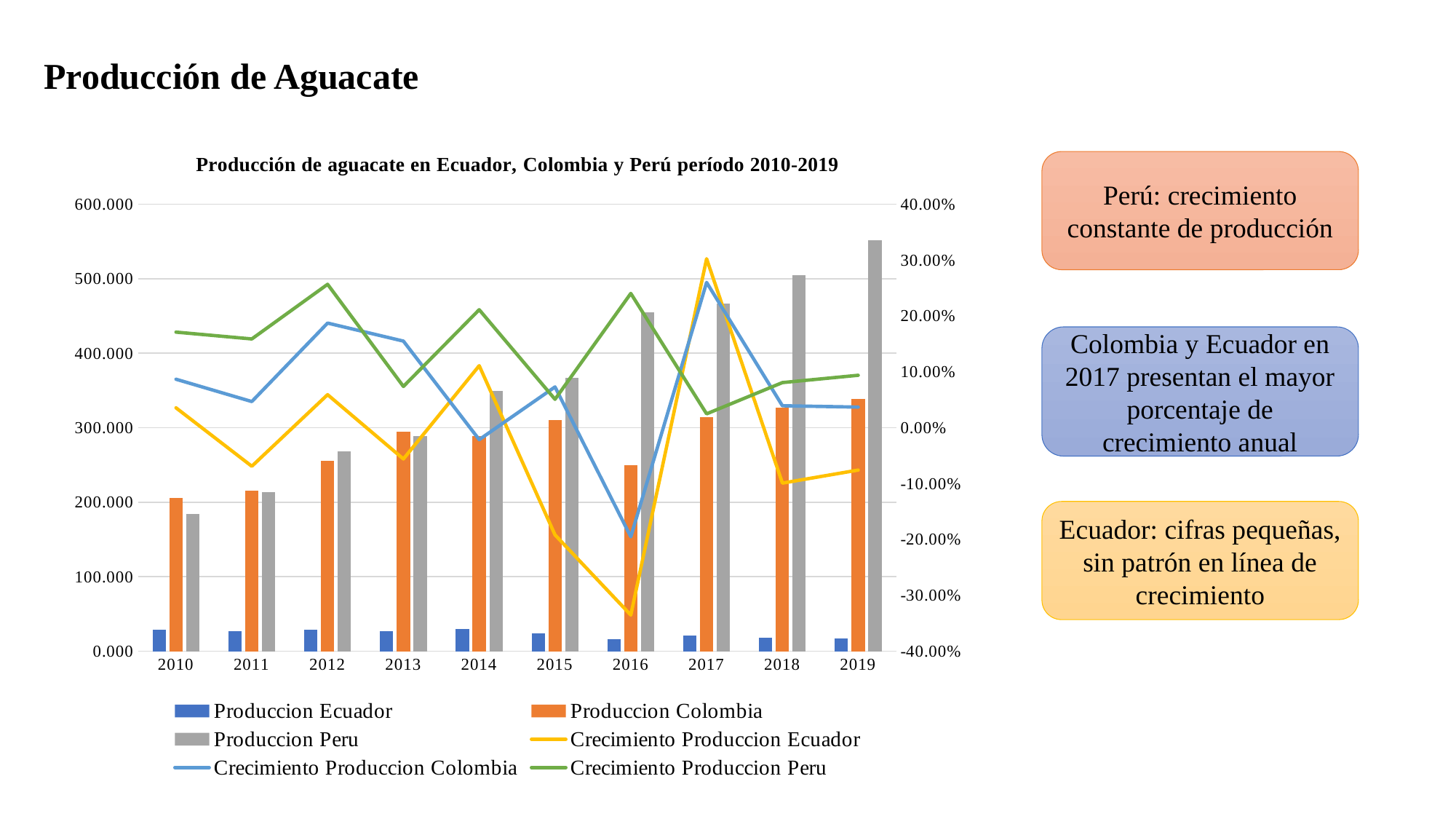
In which year is Crecimiento Produccion Ecuador lowest? 2016 In which year is Crecimiento Produccion Colombia highest? 2017 Which is larger in 2019, Produccion Peru or Produccion Colombia? Produccion Peru How many series does the legend list? 6 What kind of chart is shown on the slide? A combination bar and line chart In which year is Produccion Peru lowest? 2010 Does Produccion Peru generally rise or fall from 2010 to 2019? Rise How many years are shown on the x axis? 10 In which year is Produccion Peru highest? 2019 Is the value for Produccion Colombia in 2016 greater or less than 300.000? less Is the value for Produccion Peru in 2019 greater or less than 500.000? greater What is the title of the chart? Producción de aguacate en Ecuador, Colombia y Perú período 2010-2019